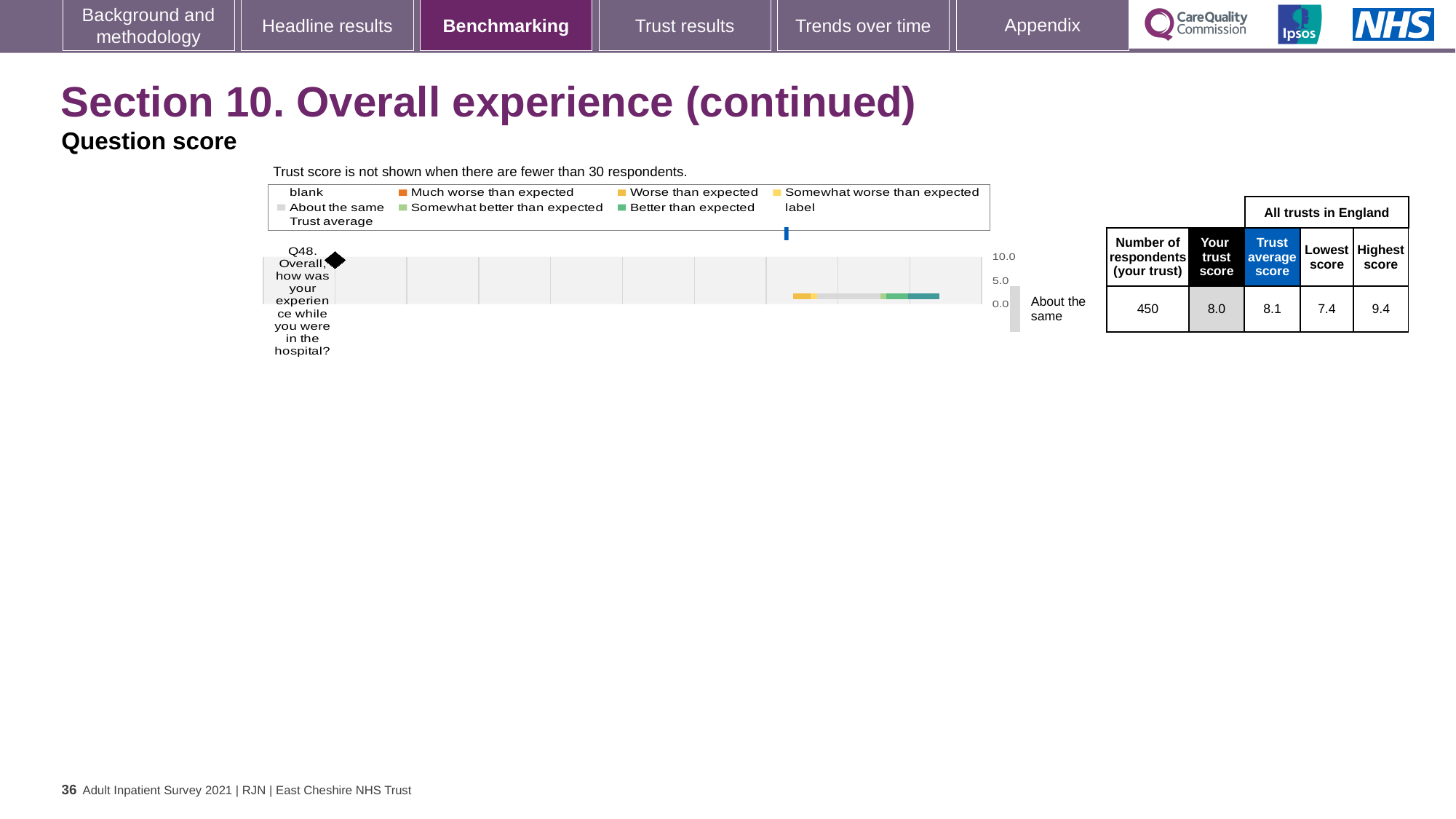
What kind of chart is used to show the Q48 benchmarking result? bar chart What is the trust average score for Q48 across all trusts in England? 8.1 What is the lowest score among all trusts in England for Q48? 7.4 What is the difference between the highest score and the lowest score for Q48? 2.0 What is the maximum value shown on the chart's axis? 10.0 Is the trust score for Q48 greater or less than 5.0? greater Which is larger for Q48, the trust score or the trust average score? Trust average score How many respondents from the trust answered Q48? 450 What is the highest score among all trusts in England for Q48? 9.4 What is the trust score for Q48 shown in the table? 8.0 How many questions are plotted on the chart? 1 What benchmarking category is the trust's Q48 result placed in? About the same